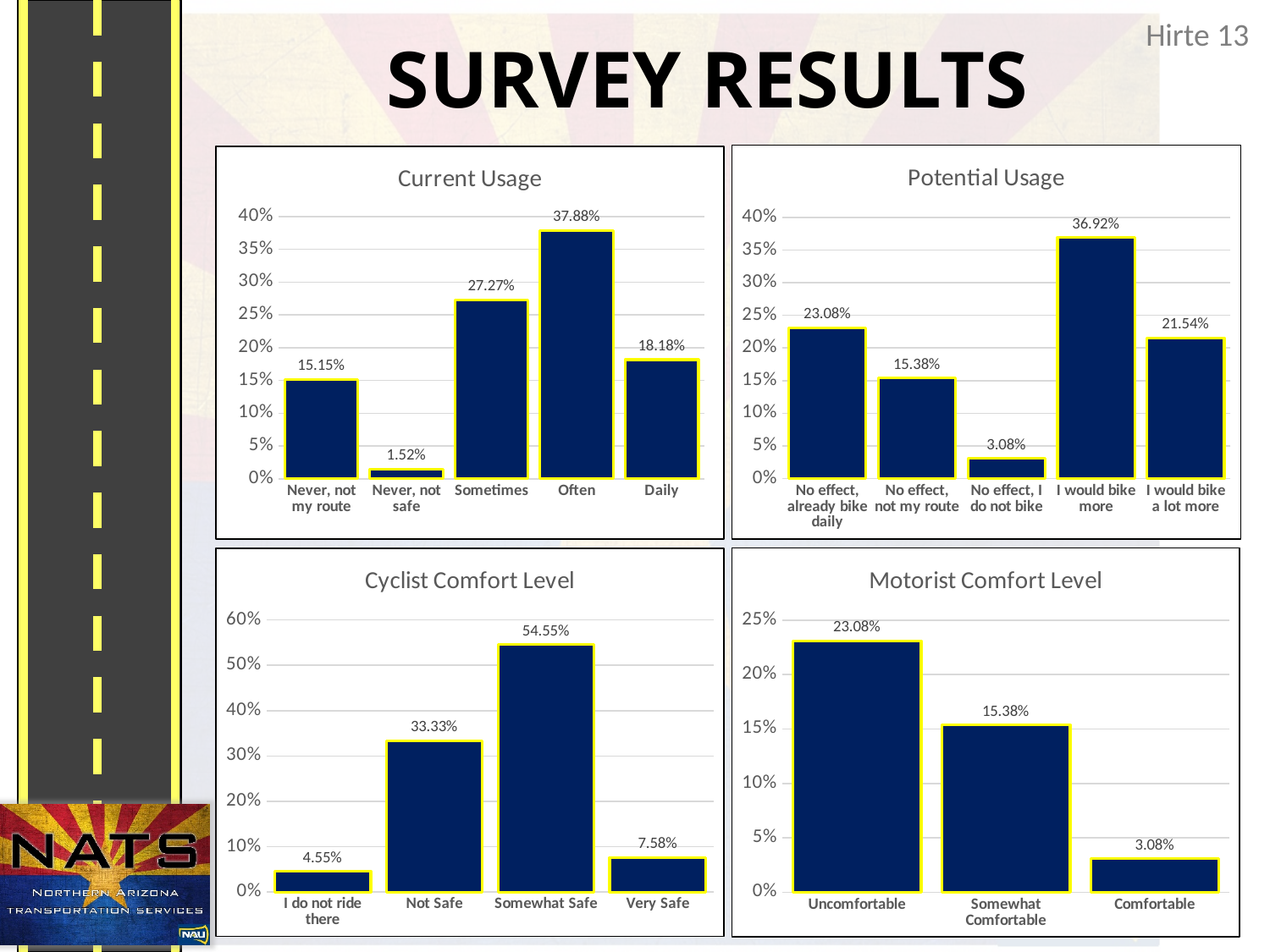
What kind of chart is the Motorist Comfort Level chart? bar chart In the Current Usage chart, which category has the lowest value? Never, not safe In the Potential Usage chart, what is the value for I would bike a lot more? 21.54% In the Current Usage chart, what is the difference between Sometimes and Daily? 9.09% In the Cyclist Comfort Level chart, what is the value for Not Safe? 33.33% How many categories are shown in the Potential Usage chart? 5 In the Motorist Comfort Level chart, do the values rise or fall from Uncomfortable to Comfortable? fall In the Current Usage chart, what is the value for Often? 37.88% In the Motorist Comfort Level chart, what is the value for Comfortable? 3.08% In the Cyclist Comfort Level chart, is the value for Somewhat Safe greater or less than 50%? greater In the Potential Usage chart, which category has the highest value? I would bike more In the Cyclist Comfort Level chart, which is larger, Very Safe or I do not ride there? Very Safe